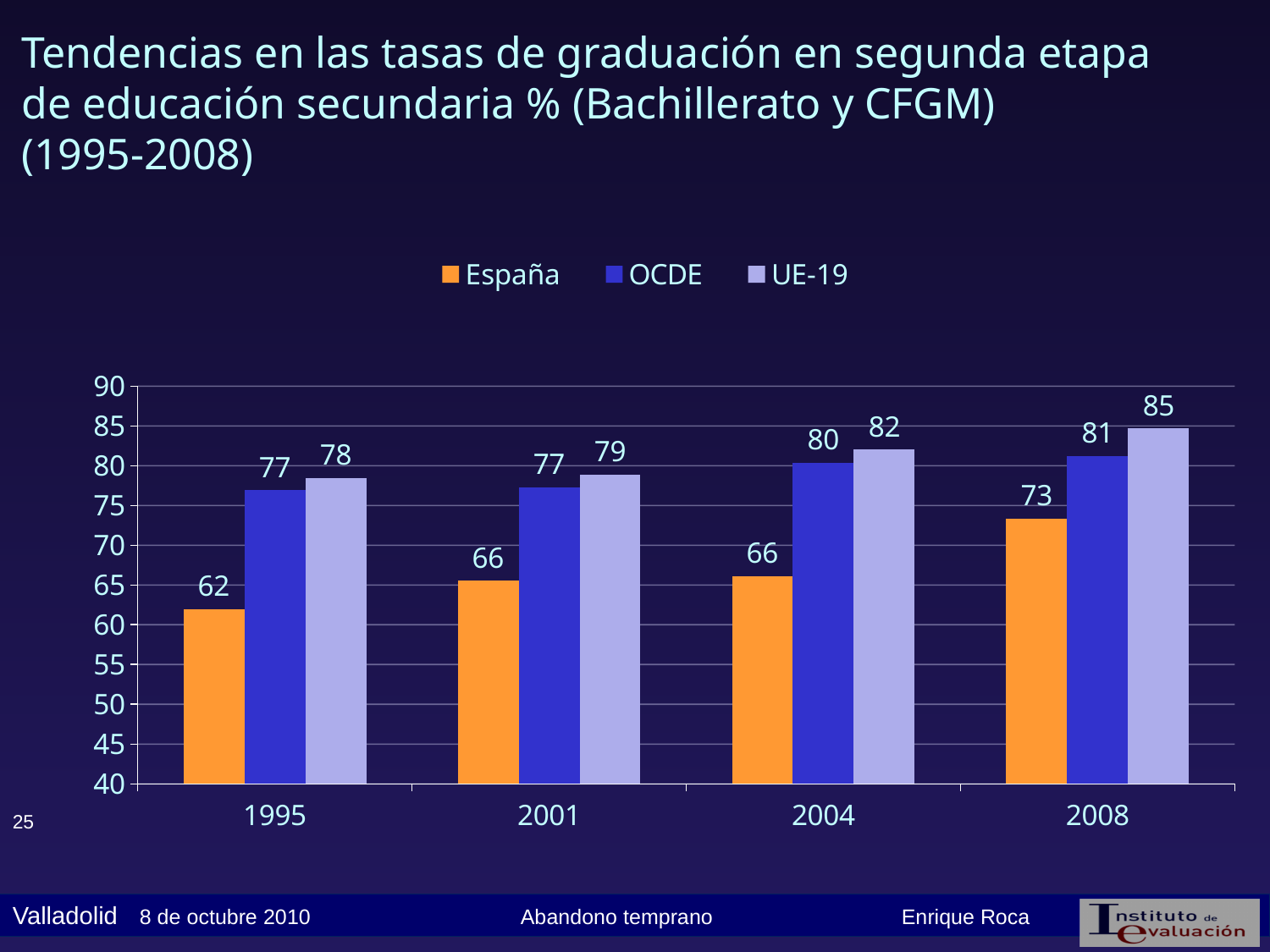
In which year is the España value highest? 2008 How many series does the legend list? 3 How many years are shown on the x axis? 4 What is the value for España in 1995? 62 Which is larger in 2001, the OCDE value or the UE-19 value? UE-19 In which year is the UE-19 value lowest? 1995 Is the value for España in 2004 greater or less than 70? less What is the difference between the UE-19 and España values in 2008? 12 What is the value for OCDE in 2004? 80 Does the España value rise or fall from 1995 to 2008? rise What kind of chart is shown on the slide? bar chart What is the value for UE-19 in 2008? 85